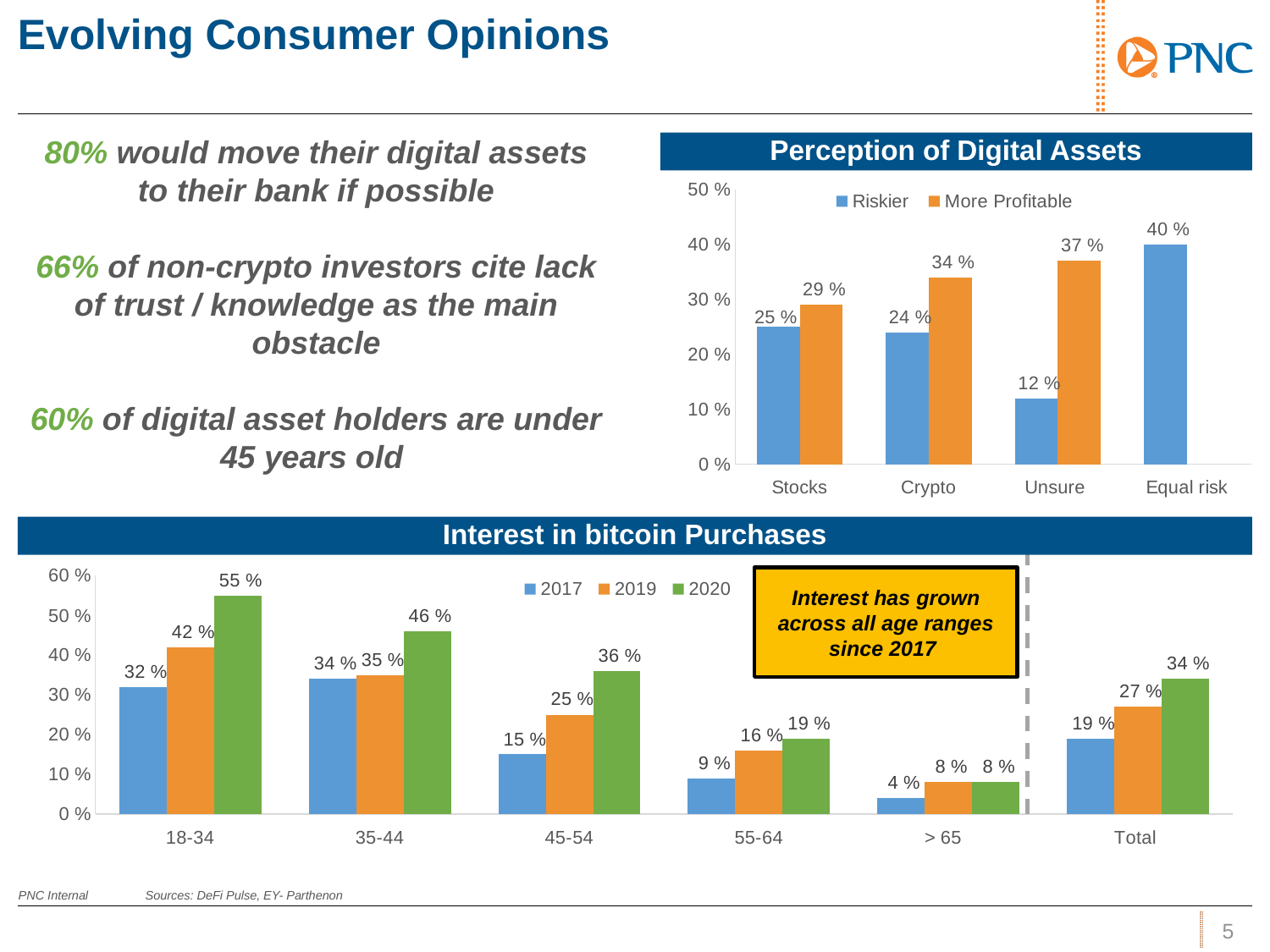
In the 'Perception of Digital Assets' chart, how many series does the legend list? 2 In the 'Interest in bitcoin Purchases' chart, which age group has the lowest 2019 value? > 65 In the 'Perception of Digital Assets' chart, what is the Riskier value for Unsure? 12 % In the 'Perception of Digital Assets' chart, what is the difference between the More Profitable and Riskier values for Unsure? 25 % In the 'Interest in bitcoin Purchases' chart, what is the difference between the 2020 and 2017 values for Total? 15 % In the 'Interest in bitcoin Purchases' chart, which is larger for the 45-54 age group: the 2019 value or the 2020 value? 2020 In the 'Perception of Digital Assets' chart, what is the More Profitable value for Crypto? 34 % In the 'Perception of Digital Assets' chart, which category has the highest Riskier value? Equal risk In the 'Interest in bitcoin Purchases' chart, how many categories are shown on the x axis? 6 In the 'Interest in bitcoin Purchases' chart, what is the 2017 value for the 55-64 age group? 9 % In the 'Interest in bitcoin Purchases' chart, what is the 2020 value for the 18-34 age group? 55 % What type of chart is the 'Interest in bitcoin Purchases' chart? Bar chart